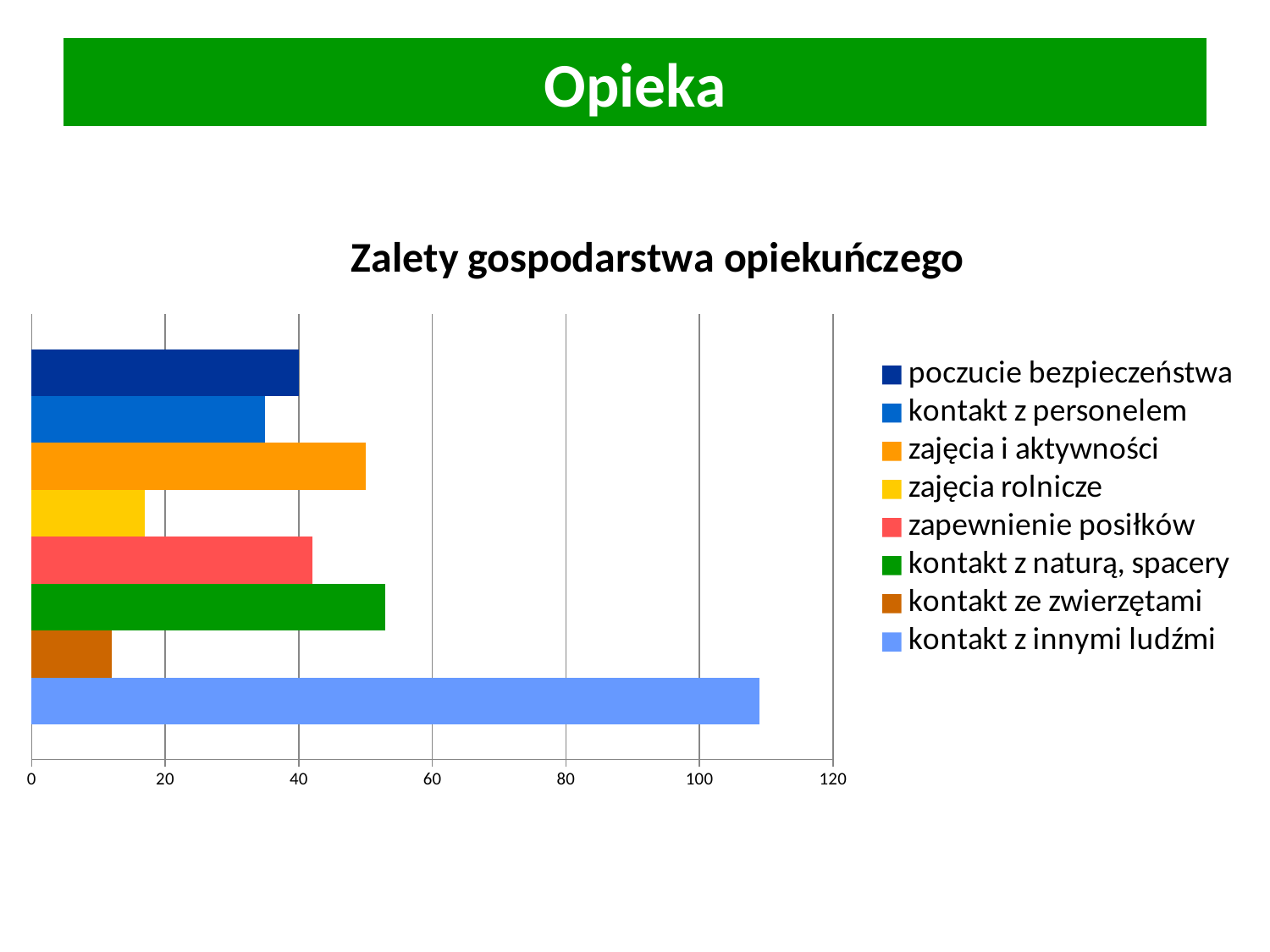
Is the value for kontakt z innymi ludźmi greater or less than 100? greater Which category has the highest value in the chart? kontakt z innymi ludźmi What colour is the bar for kontakt z innymi ludźmi? light blue Is the value for zajęcia rolnicze greater or less than 20? less Is the value for zajęcia i aktywności greater or less than 40? greater How many entries does the chart's legend list? 8 Which is larger: the value for kontakt z naturą, spacery or the value for zapewnienie posiłków? kontakt z naturą, spacery Which is larger: the value for zajęcia i aktywności or the value for kontakt z personelem? zajęcia i aktywności What kind of chart is shown on the slide? bar chart What is the title of the chart? Zalety gospodarstwa opiekuńczego Which category has the lowest value in the chart? kontakt ze zwierzętami How many bars are plotted in the chart? 8